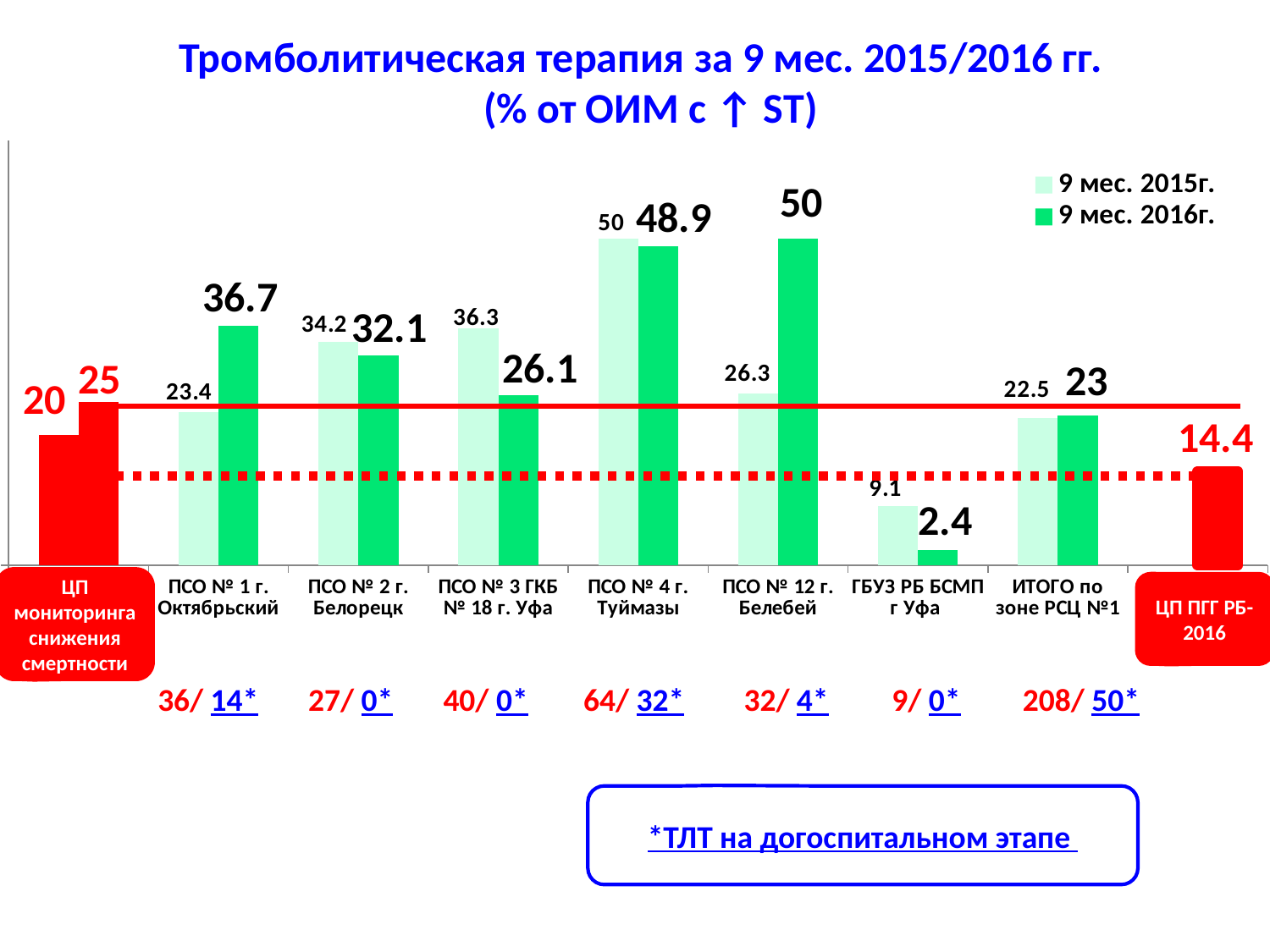
How many series does the legend list? 2 What is the value for ПСО № 3 ГКБ № 18 г. Уфа in the 9 мес. 2015г. series? 36.3 Which category has the highest value in the 9 мес. 2016г. series? ПСО № 12 г. Белебей What is the difference between the 9 мес. 2016г. and 9 мес. 2015г. values for ПСО № 12 г. Белебей? 23.7 What is the value for ПСО № 1 г. Октябрьский in the 9 мес. 2016г. series? 36.7 What is the value for ИТОГО по зоне РСЦ №1 in the 9 мес. 2015г. series? 22.5 What kind of chart is shown on the slide? Bar chart Which category has the lowest value in the 9 мес. 2015г. series? ГБУЗ РБ БСМП г Уфа Which is larger for ПСО № 2 г. Белорецк: the 9 мес. 2015г. value or the 9 мес. 2016г. value? 9 мес. 2015г. What is the value for ГБУЗ РБ БСМП г Уфа in the 9 мес. 2016г. series? 2.4 What is the value shown for ЦП ПГГ РБ-2016? 14.4 What is the title of the chart? Тромболитическая терапия за 9 мес. 2015/2016 гг. (% от ОИМ с ↑ ST)